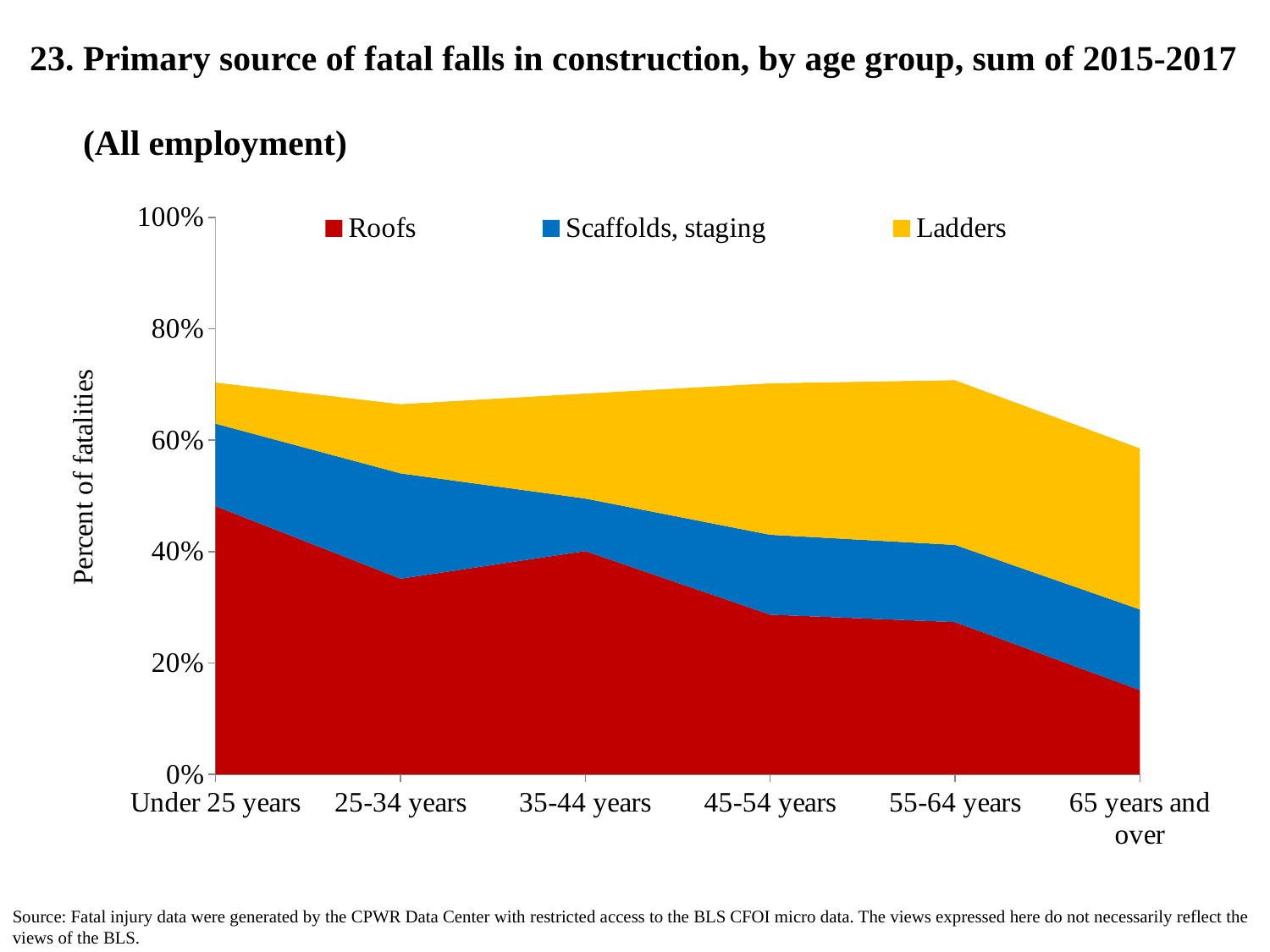
Does the Roofs share generally rise or fall from the youngest to the oldest age group? fall Which series is shown in red? Roofs For which age group is the Roofs share highest? Under 25 years How many series does the legend list? 3 What is the y-axis label of the chart? Percent of fatalities Is the Roofs share for 25-34 years greater or less than 40%? less Is the Roofs share for 65 years and over greater or less than 20%? less What kind of chart is shown on the slide? Stacked area chart How many age groups are shown along the x axis? 6 For which age group is the Roofs share lowest? 65 years and over Is the Roofs share larger for Under 25 years or for 65 years and over? Under 25 years Is the Roofs share for Under 25 years greater or less than 40%? greater